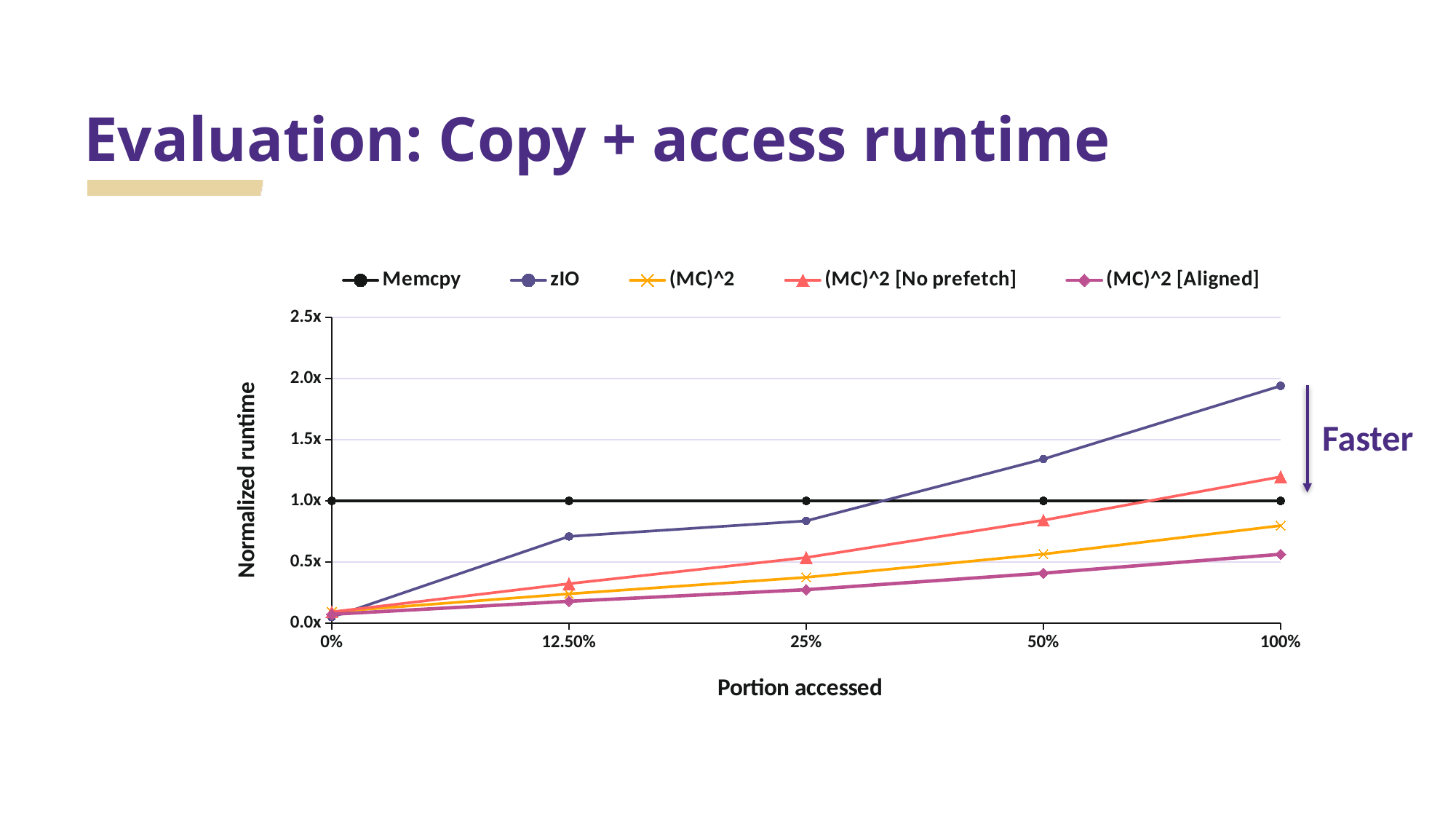
Is the value for zIO at 100% portion accessed greater or less than 1.5x? greater What is the normalized runtime for Memcpy at 50% portion accessed? 1.0x Does the zIO series rise or fall as portion accessed increases along the x axis? rise What is the title of the x axis? Portion accessed How many series does the legend list? 5 Which series has the highest normalized runtime at 100% portion accessed? zIO What kind of chart is shown on the slide? line chart How many portion-accessed categories are shown on the x axis? 5 At 25% portion accessed, which is larger: zIO or (MC)^2 [No prefetch]? zIO Is the value for (MC)^2 [No prefetch] at 50% portion accessed greater or less than 1.0x? less Is the value for (MC)^2 at 100% portion accessed greater or less than 1.0x? less Which series has the lowest normalized runtime at 100% portion accessed? (MC)^2 [Aligned]